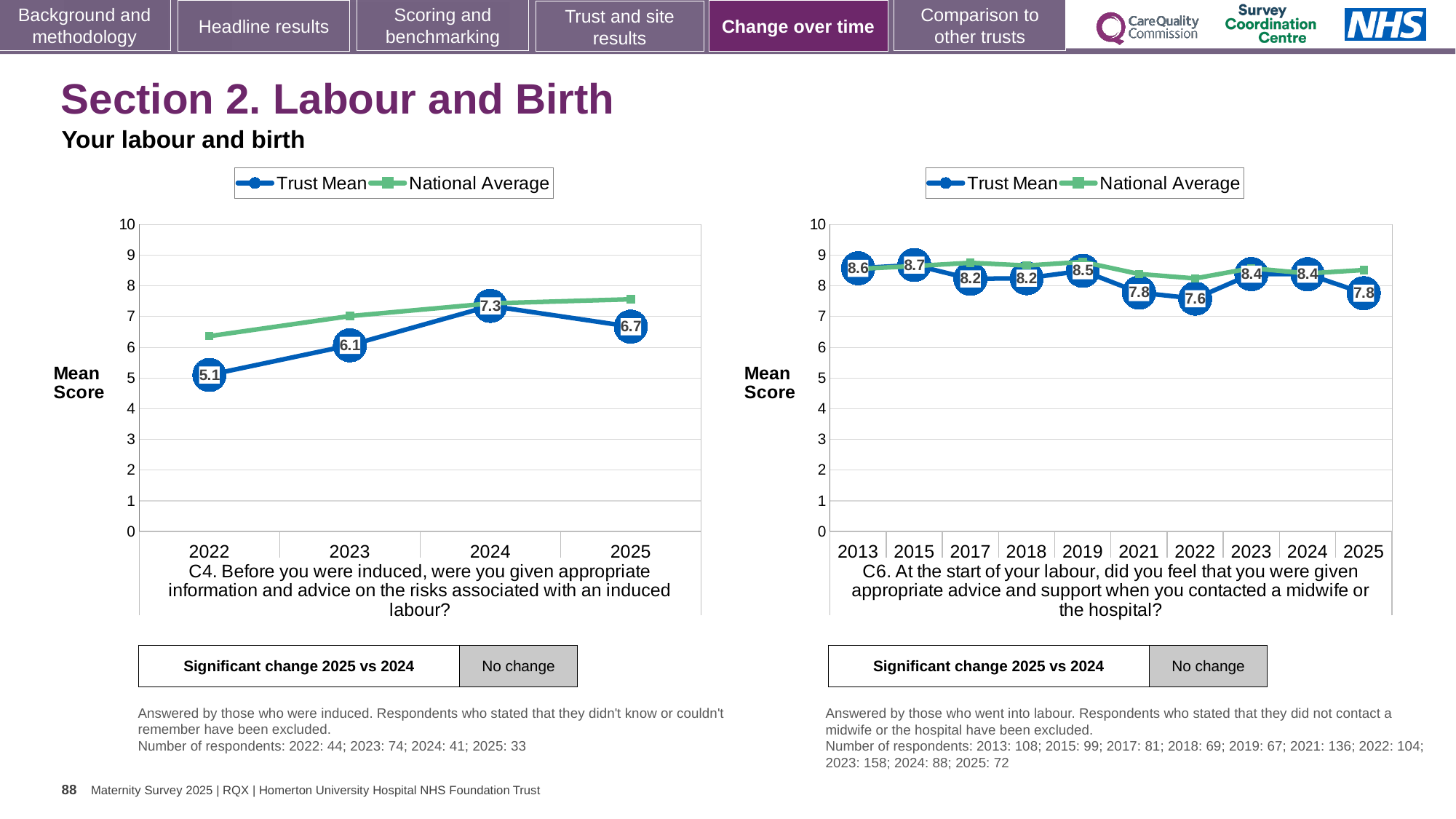
What type of chart is the right chart (C6)? line chart In the left chart (C4), what is the difference between the Trust Mean in 2024 and in 2022? 2.2 In the right chart (C6), which is larger, the Trust Mean for 2015 or for 2021? 2015 In the right chart (C6), which year has the lowest Trust Mean? 2022 In the left chart (C4), how many years are shown on the x axis? 4 In the left chart (C4), which year has the highest Trust Mean? 2024 In the left chart (C4), what is the Trust Mean for 2022? 5.1 In the right chart (C6), how many series does the legend list? 2 In the left chart (C4), does the Trust Mean rise or fall from 2022 to 2024? rise In the left chart (C4), is the National Average for 2022 greater or less than 6? greater In the right chart (C6), what is the Trust Mean for 2019? 8.5 In the right chart (C6), how many years are plotted on the x axis? 10